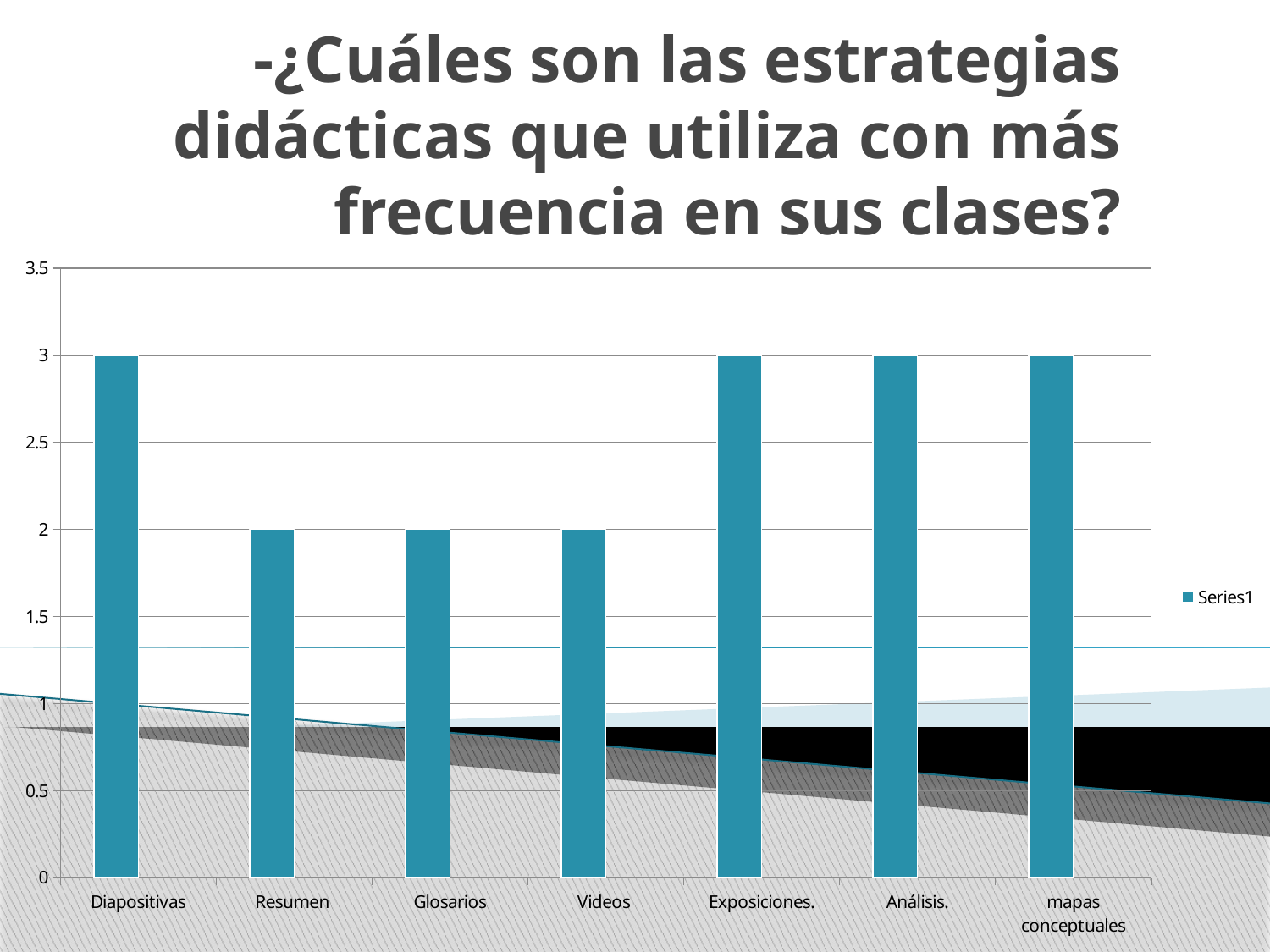
What is the value for mapas conceptuales? 3 How many series does the legend list? 1 What kind of chart is shown on the slide? bar chart What is the value for Diapositivas? 3 Which is larger, the value for Videos or the value for Exposiciones.? Exposiciones. What is the value for Videos? 2 Is the value for Resumen greater or less than 2.5? less What is the value for Resumen? 2 What is the difference between the value for Análisis. and the value for Glosarios? 1 What is the value for Glosarios? 2 How many categories are shown on the x axis? 7 Which is larger, the value for Diapositivas or the value for Resumen? Diapositivas